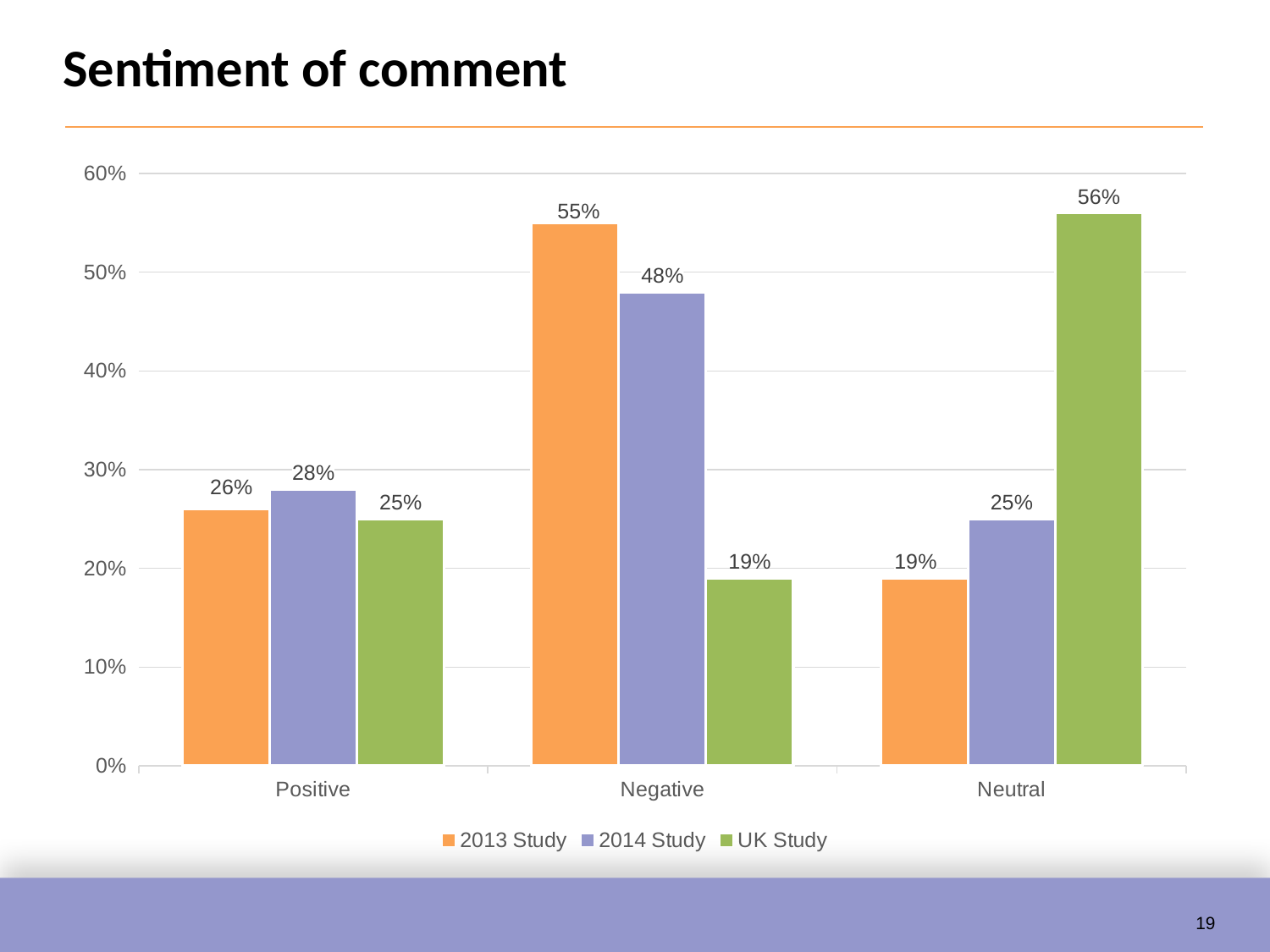
What is the value for the UK Study in the Neutral category? 56% Which category has the highest value for the 2013 Study? Negative How many categories are shown on the x axis? 3 What is the difference between the 2013 Study and the 2014 Study values in the Negative category? 7% Which colour represents the UK Study in the chart? Green How many series does the legend list? 3 Which is larger in the Neutral category: the 2014 Study or the UK Study? UK Study Which category has the lowest value for the UK Study? Negative What is the value for the 2013 Study in the Negative category? 55% Is the value for the 2014 Study in the Negative category greater or less than 40%? greater What kind of chart is shown on the slide? Bar chart What is the value for the 2014 Study in the Positive category? 28%